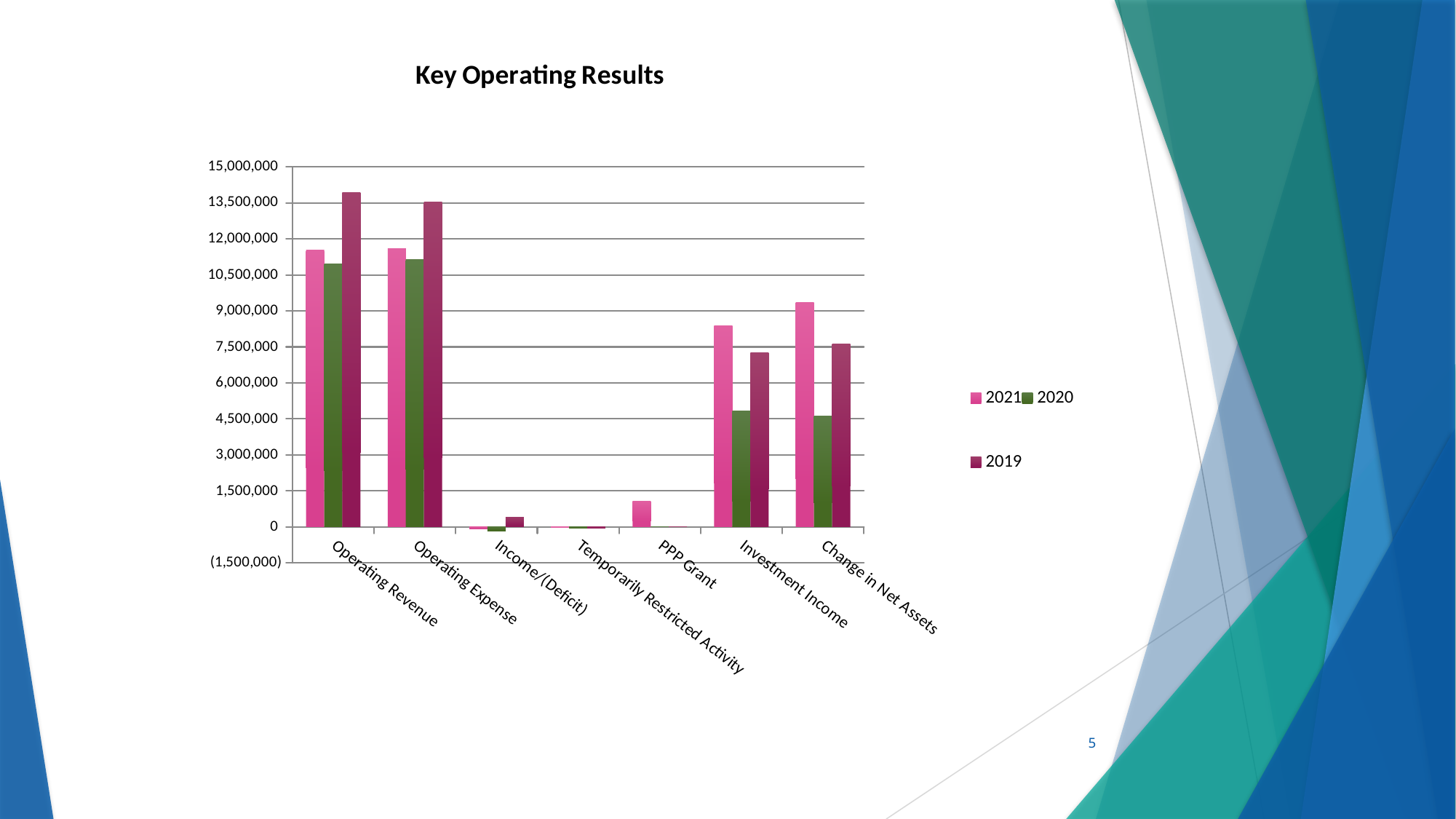
Which is larger for Change in Net Assets, the 2021 value or the 2020 value? 2021 Is the 2020 value for Operating Expense greater or less than 12,000,000? less What kind of chart is shown on the slide? bar chart Is the 2020 value for Investment Income greater or less than 6,000,000? less Is the 2021 value for PPP Grant greater or less than 1,500,000? less Which year has the lowest Change in Net Assets? 2020 Which is larger for Investment Income, the 2021 value or the 2019 value? 2021 How many categories are shown on the x axis? 7 What is the title of the chart? Key Operating Results How many series does the legend list? 3 Which year has the highest Operating Revenue? 2019